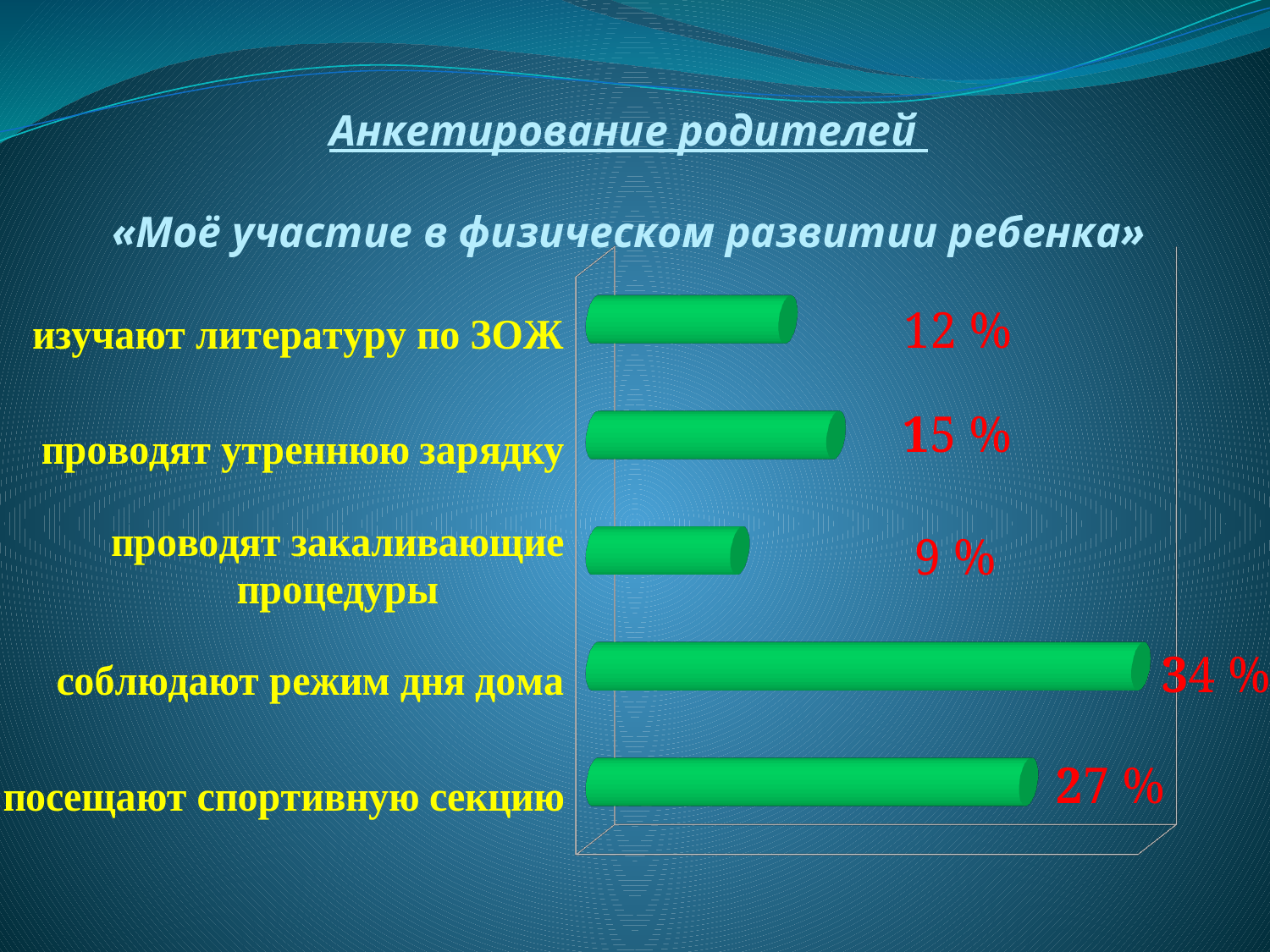
Which category has the highest value? соблюдают режим дня дома Which category has the lowest value? проводят закаливающие процедуры What is the difference between the values for «проводят утреннюю зарядку» and «изучают литературу по ЗОЖ»? 3 % What value is shown for «соблюдают режим дня дома»? 34 % What colour are the bars in the chart? green What value is shown for «изучают литературу по ЗОЖ»? 12 % What kind of chart is shown on the slide? bar chart Which is larger: the value for «проводят утреннюю зарядку» or for «проводят закаливающие процедуры»? проводят утреннюю зарядку What is the difference between the values for «соблюдают режим дня дома» and «посещают спортивную секцию»? 7 % How many categories are shown in the chart? 5 What value is shown for «посещают спортивную секцию»? 27 % What value is shown for «проводят закаливающие процедуры»? 9 %